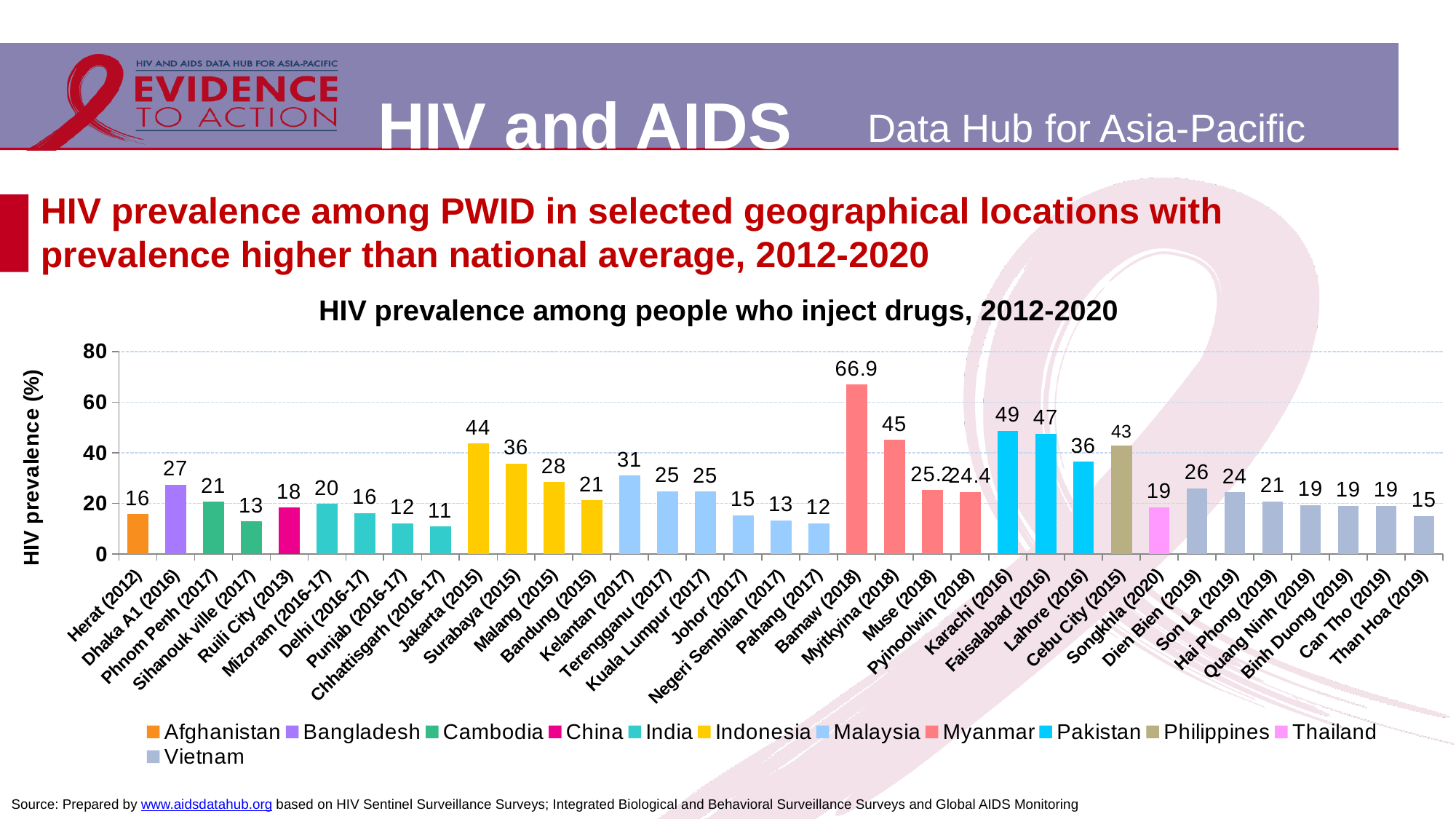
What is the HIV prevalence value shown for Muse (2018)? 25.2 What is the difference between the HIV prevalence values for Jakarta (2015) and Bandung (2015)? 23 How many locations (bars) are plotted in the chart? 35 Which location has the highest HIV prevalence in the chart? Bamaw (2018) What type of chart is shown on the slide? Bar chart Which location has the lowest HIV prevalence in the chart? Chhattisgarh (2016-17) Which has a higher HIV prevalence, Faisalabad (2016) or Lahore (2016)? Faisalabad (2016) What is the HIV prevalence value shown for Karachi (2016)? 49 What is the HIV prevalence value shown for Bamaw (2018)? 66.9 How many countries are listed in the chart legend? 12 Is the value for Myitkyina (2018) greater or less than 40? greater What is the HIV prevalence value shown for Cebu City (2015)? 43